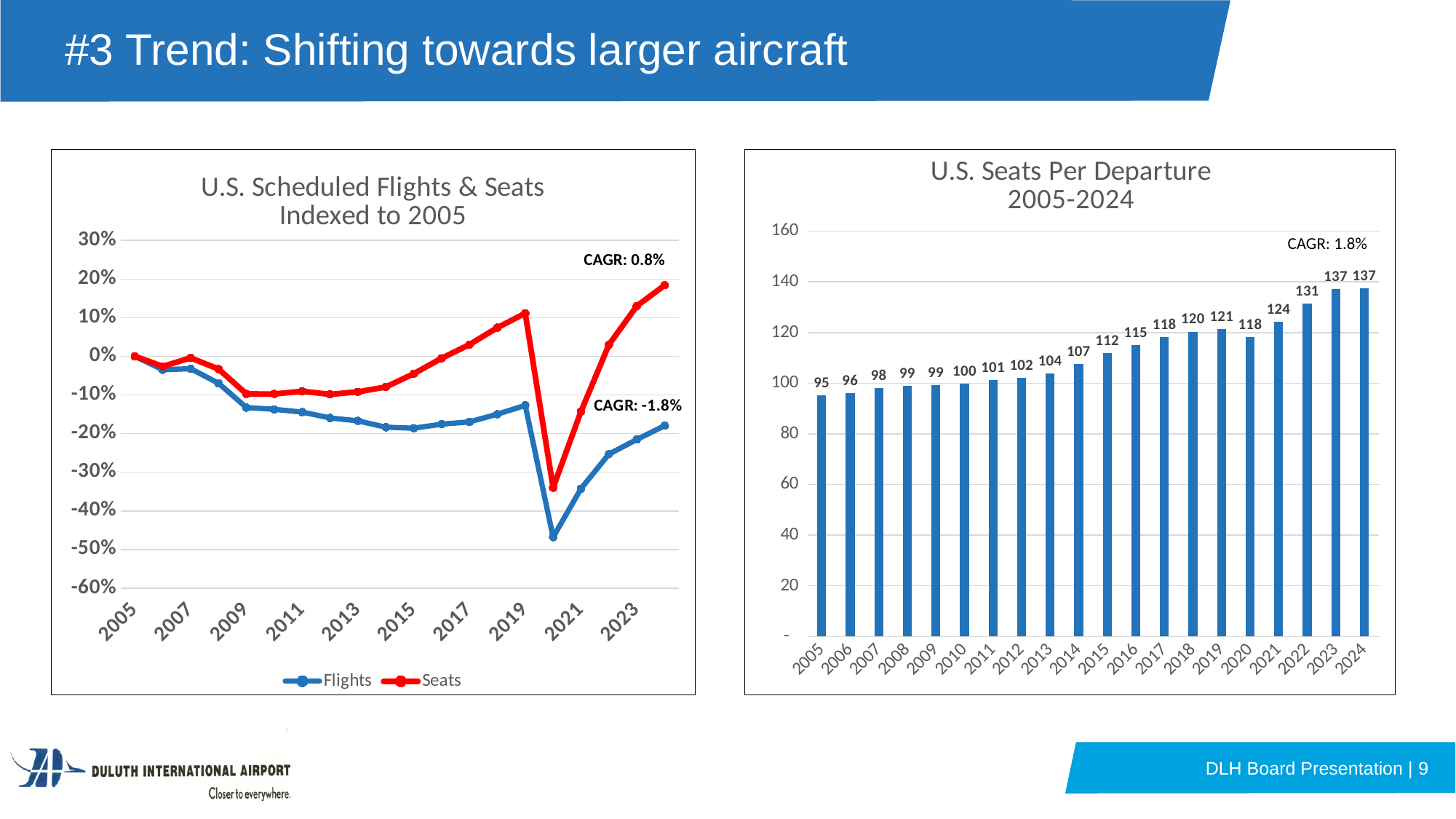
In the U.S. Scheduled Flights & Seats chart, is the Flights value for 2020 greater or less than -40%? less In the U.S. Scheduled Flights & Seats chart, is the Seats value for 2024 greater or less than 10%? greater In the U.S. Seats Per Departure chart, which is larger, the value for 2019 or the value for 2020? 2019 In the U.S. Seats Per Departure chart, what is the value for 2005? 95 What kind of chart is the U.S. Seats Per Departure chart? bar chart In the U.S. Seats Per Departure chart, what is the difference between the 2024 value and the 2005 value? 42 In the U.S. Seats Per Departure chart, which year has the lowest value? 2005 In the U.S. Seats Per Departure chart, what is the value for 2022? 131 In the U.S. Seats Per Departure chart, how many years are shown on the x axis? 20 In the U.S. Seats Per Departure chart, what is the value for 2020? 118 In the U.S. Seats Per Departure chart, what CAGR is annotated on the chart? 1.8% In the U.S. Scheduled Flights & Seats chart, how many series does the legend list? 2